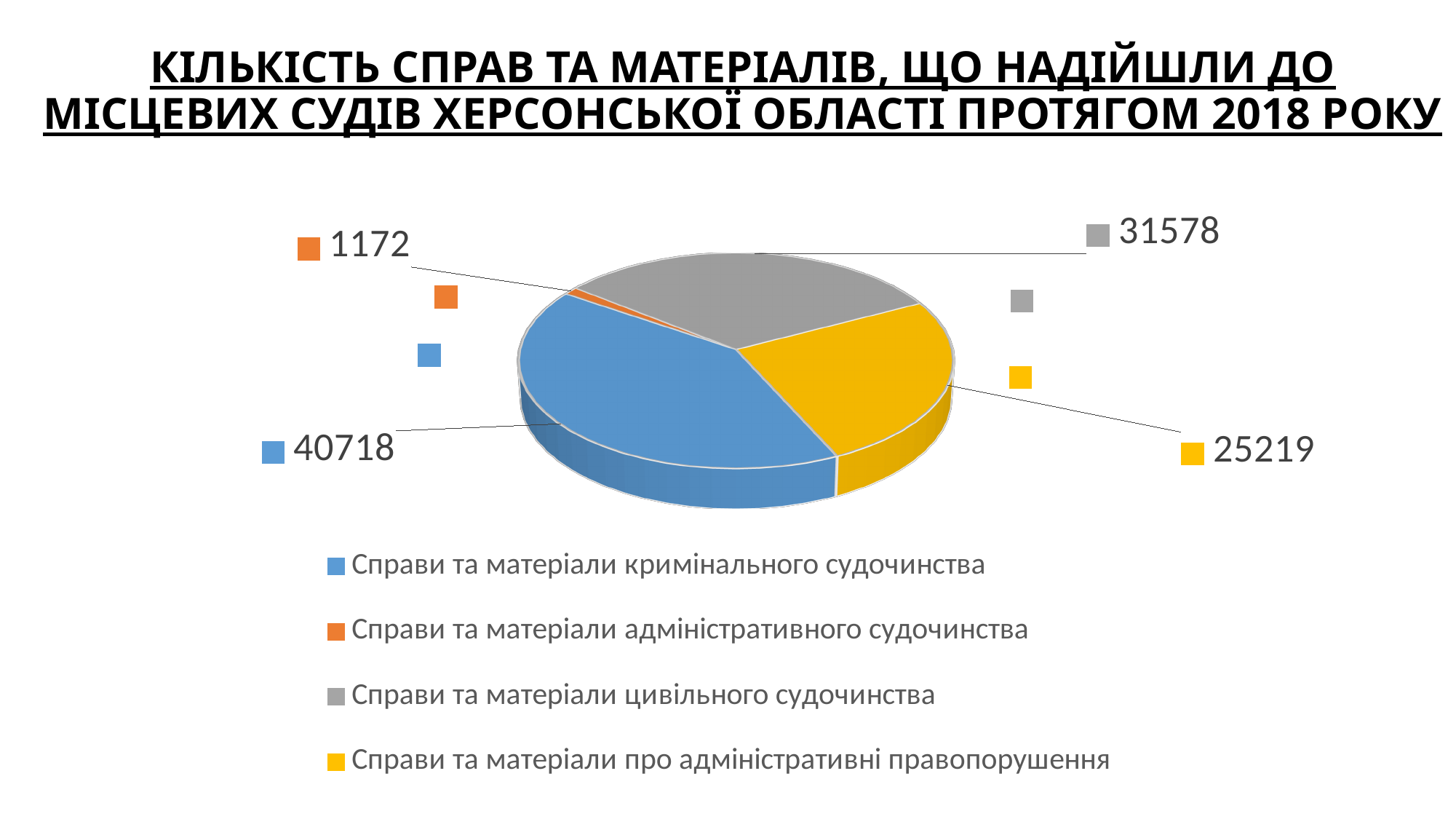
Which category has the smallest slice of the pie? Справи та матеріали адміністративного судочинства What is the difference between the values for "Справи та матеріали кримінального судочинства" and "Справи та матеріали цивільного судочинства"? 9140 What is the value for "Справи та матеріали адміністративного судочинства"? 1172 What is the value for "Справи та матеріали про адміністративні правопорушення"? 25219 How many entries does the legend list? 4 Which category has the largest slice of the pie? Справи та матеріали кримінального судочинства What is the value for "Справи та матеріали цивільного судочинства"? 31578 What is the value for "Справи та матеріали кримінального судочинства"? 40718 How many slices does the pie chart have? 4 Which is larger: the value for "Справи та матеріали цивільного судочинства" or for "Справи та матеріали про адміністративні правопорушення"? Справи та матеріали цивільного судочинства What colour is the slice for "Справи та матеріали про адміністративні правопорушення"? Yellow What type of chart is shown on the slide? Pie chart